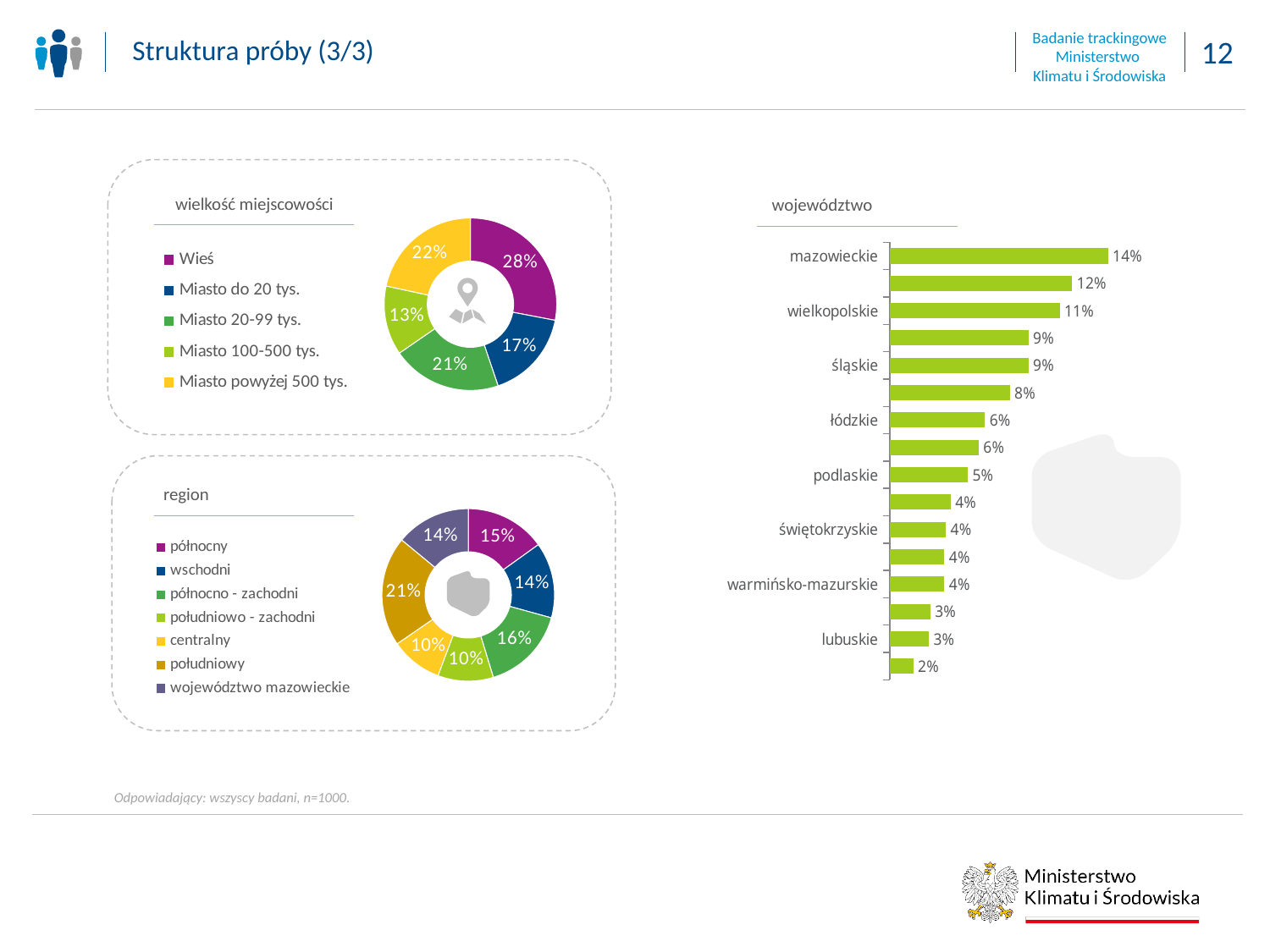
In the 'wielkość miejscowości' chart, which category has the largest share? Wieś In the 'region' chart, how many regions are listed in the legend? 7 In the 'wielkość miejscowości' chart, what share is Wieś? 28% In the 'województwo' chart, what is the value for podlaskie? 5% In the 'województwo' chart, what is the difference between wielkopolskie and śląskie? 2 percentage points In the 'region' chart, which region has the largest share? południowy In the 'region' chart, what share is południowy? 21% In the 'wielkość miejscowości' chart, what share is Miasto 100-500 tys.? 13% In the 'wielkość miejscowości' chart, what is the difference between Wieś and Miasto do 20 tys.? 11 percentage points What type of chart is the 'województwo' chart? Bar chart In the 'region' chart, which is larger: północny or północno - zachodni? północno - zachodni In the 'województwo' chart, what is the value for mazowieckie? 14%